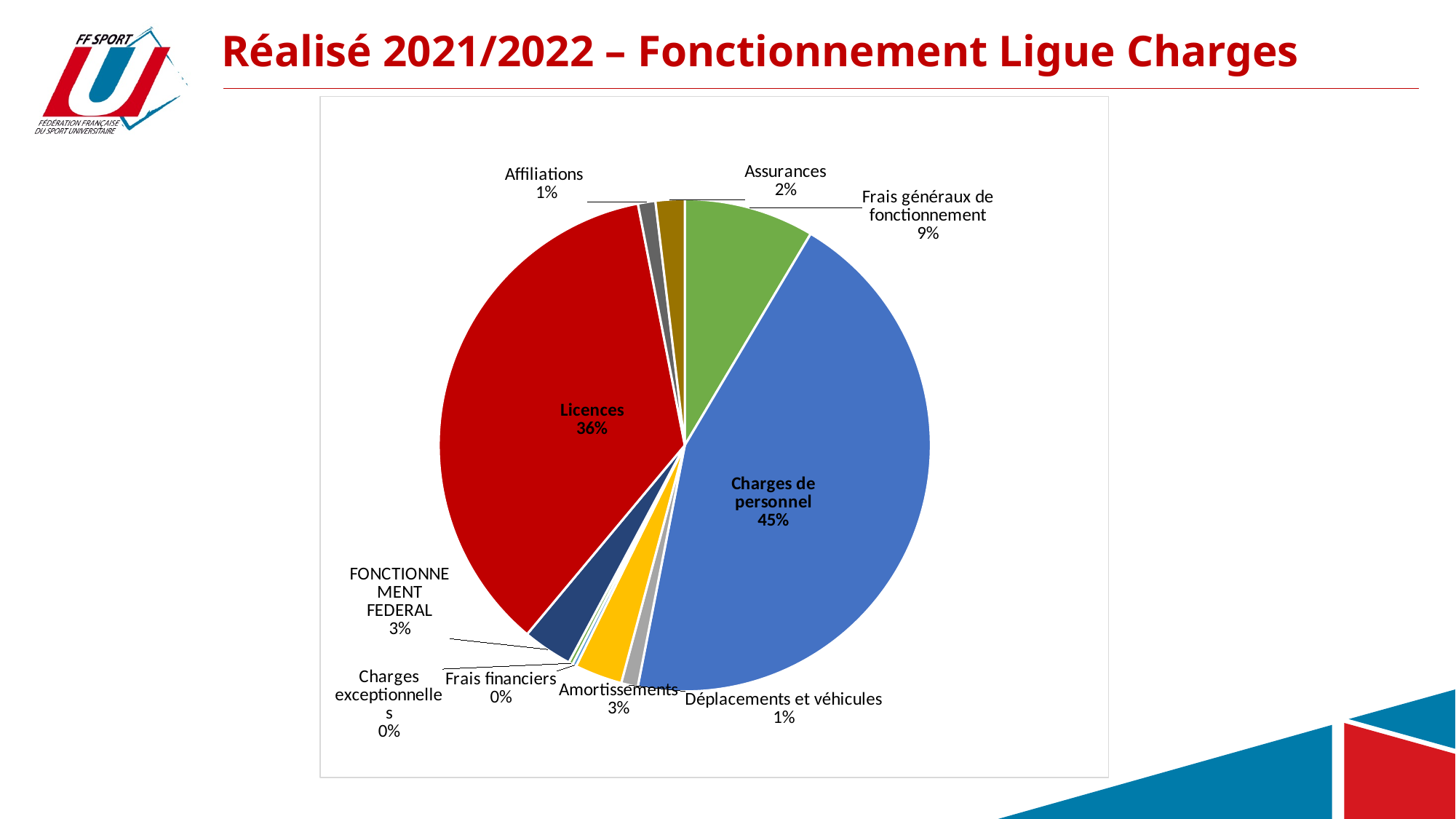
Which is larger, Frais généraux de fonctionnement or FONCTIONNEMENT FEDERAL? Frais généraux de fonctionnement What share of the pie does Licences represent? 36% What is the value shown for Frais généraux de fonctionnement? 9% Which category has the largest slice of the pie? Charges de personnel What share of the pie does Charges de personnel represent? 45% What kind of chart is shown on the slide? pie chart What is the difference in percentage points between Charges de personnel and Licences? 9 What is the value shown for Assurances? 2% What is the value shown for Frais financiers? 0% What is the title of the slide containing the chart? Réalisé 2021/2022 – Fonctionnement Ligue Charges How many categories are shown in the pie chart? 10 What is the value shown for Amortissements? 3%